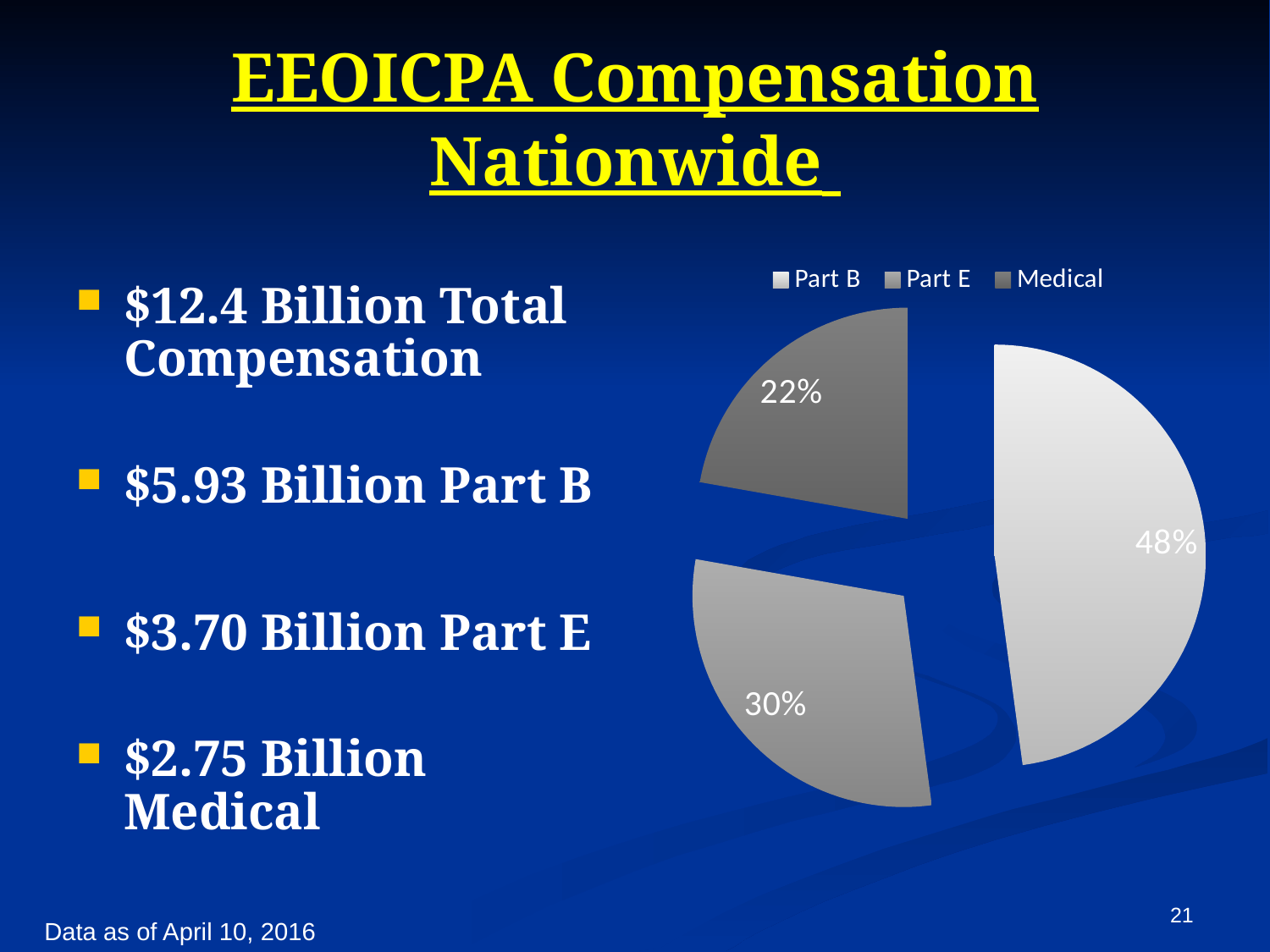
What is the difference in percentage points between the Part B slice and the Part E slice? 18 How many slices does the pie chart have? 3 How many entries does the legend list? 3 Which is larger, the Part E slice or the Medical slice? Part E What share of the pie does Part B represent? 48% Which slice of the pie is the largest? Part B What kind of chart is shown on the slide? pie chart What share of the pie does Medical represent? 22% What share of the pie does Part E represent? 30% Which legend entry is listed first? Part B What is the difference in percentage points between the Part E slice and the Medical slice? 8 Which slice of the pie is the smallest? Medical